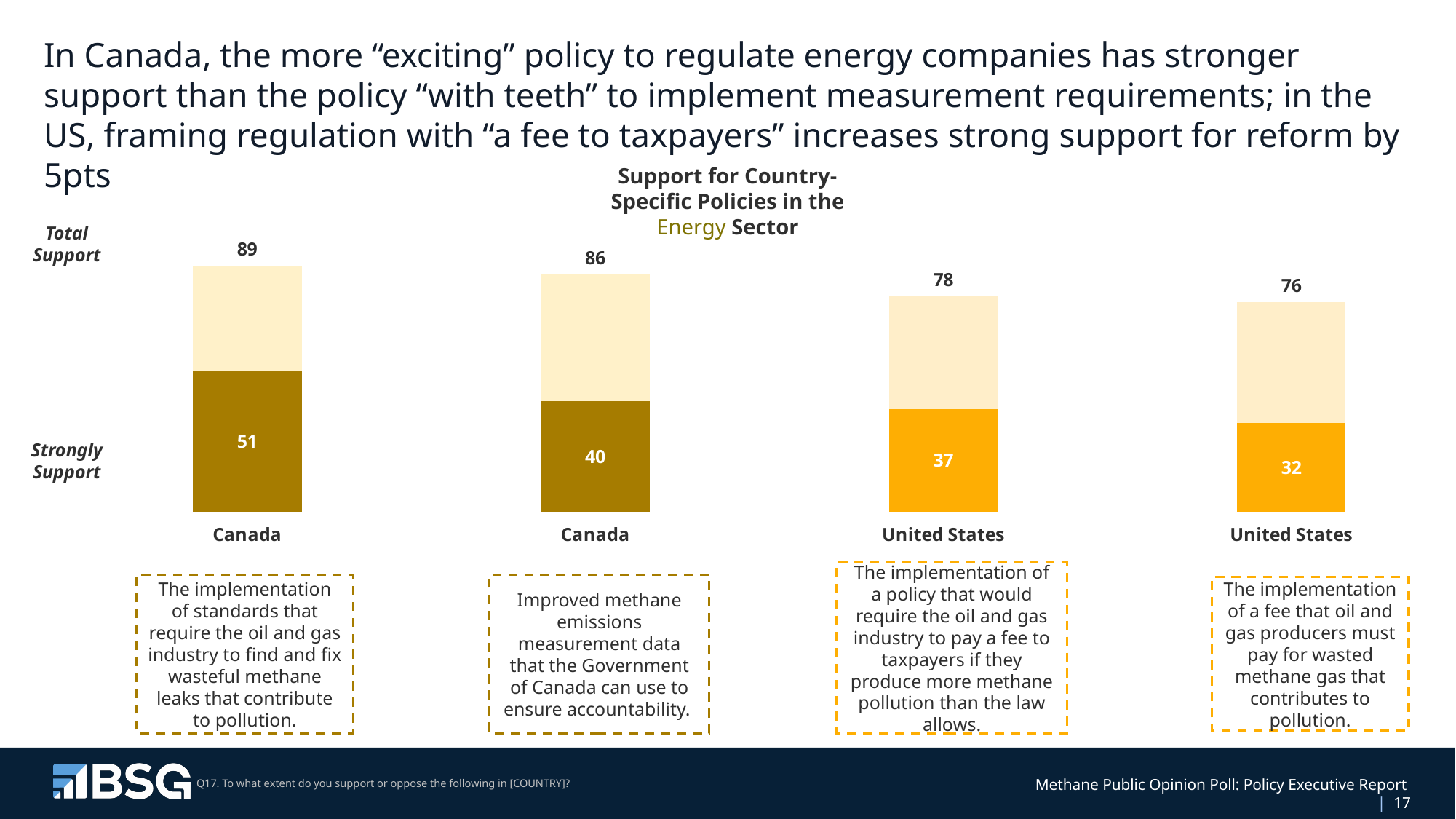
Which bar has the highest Total Support? Canada (find and fix methane leaks), leftmost bar What is the Total Support value for the leftmost Canada bar (standards requiring the oil and gas industry to find and fix methane leaks)? 89 What is the difference in Strongly Support between the two Canada bars (51 vs 40)? 11 What is the Strongly Support value for the second Canada bar (improved methane emissions measurement data)? 40 How many bars are shown in the chart? 4 What is the difference in Strongly Support between the two United States bars (37 vs 32)? 5 What is the Strongly Support value for the rightmost United States bar (fee for wasted methane gas)? 32 Which bar has the lowest Strongly Support value? United States (fee for wasted methane gas), rightmost bar What kind of chart is shown on the slide? Bar chart What is the title of the chart? Support for Country-Specific Policies in the Energy Sector Which United States policy has the larger Strongly Support value: the fee to taxpayers or the fee for wasted methane gas? The fee to taxpayers (37) What is the Total Support value for the United States bar about a fee to taxpayers for excess methane pollution? 78